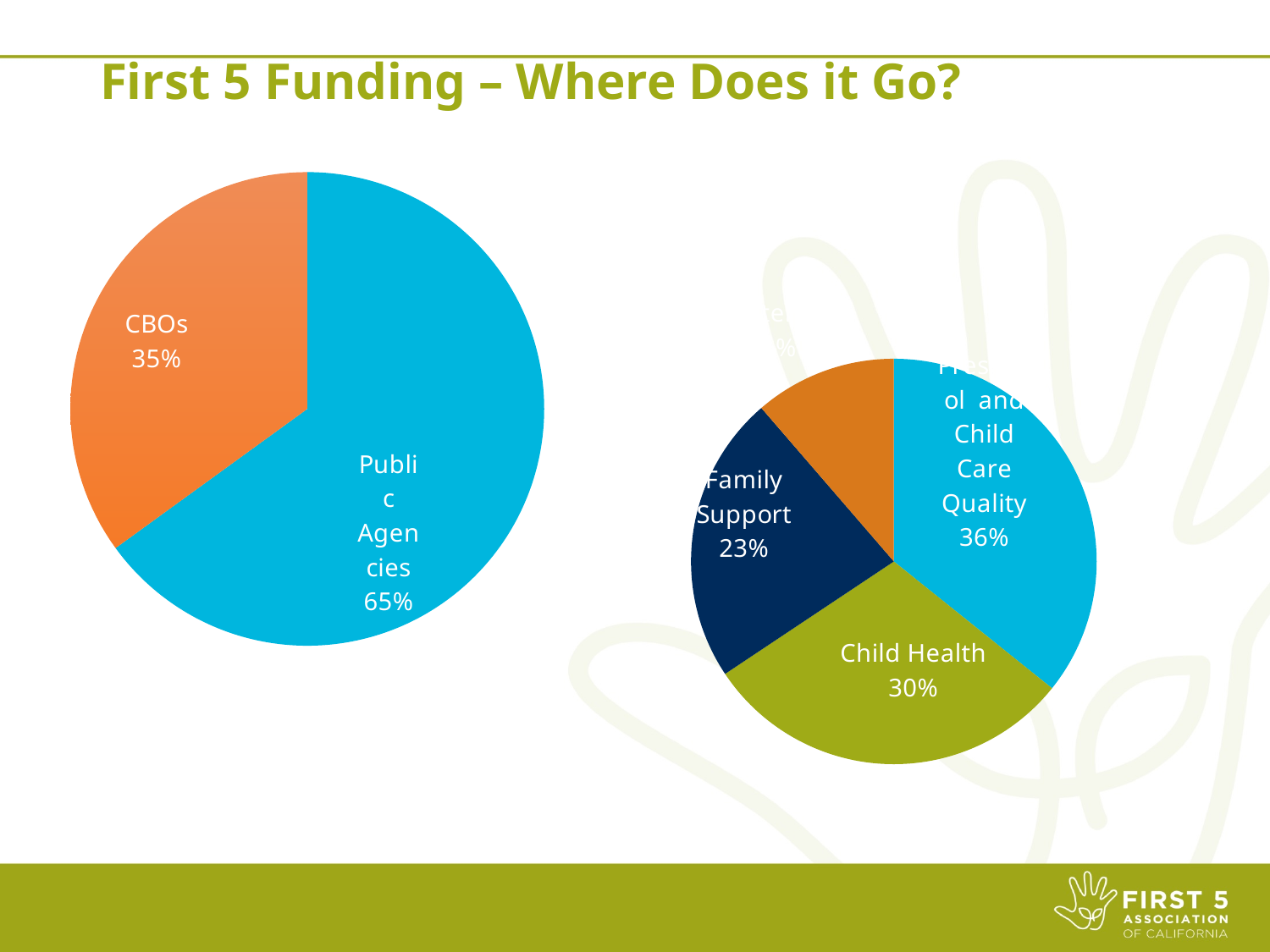
In the right pie chart, what share goes to Child Health? 30% In the right pie chart, how many percentage points larger is Child Health than Family Support? 7 percentage points In the left pie chart, which slice is larger, CBOs or Public Agencies? Public Agencies What kind of chart is the chart on the left of the slide? Pie chart In the left pie chart, how many percentage points larger is the Public Agencies share than the CBOs share? 30 percentage points In the right pie chart, what share goes to Preschool and Child Care Quality? 36% How many slices does the left pie chart have? 2 In the right pie chart, which slice is the largest? Preschool and Child Care Quality In the left pie chart, what share of funding goes to Public Agencies? 65% What is the title of the slide containing the two pie charts? First 5 Funding – Where Does it Go?